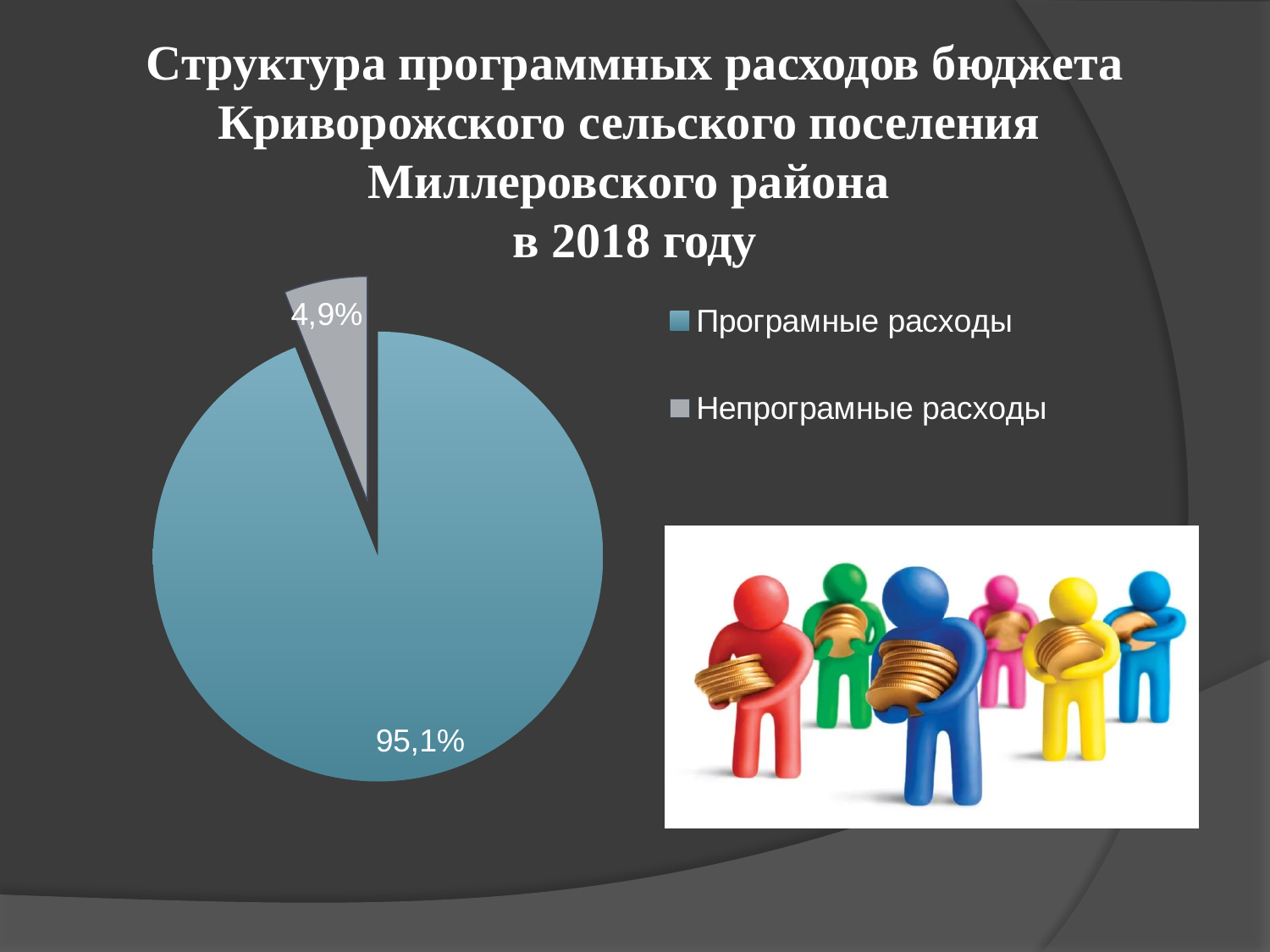
What share of the pie does Програмные расходы take? 95,1% How many slices does the pie chart have? 2 What colour is the slice for Програмные расходы? blue What kind of chart is shown on the slide? pie chart Which category has the smallest slice of the pie? Непрограмные расходы What is the difference between the shares of Програмные расходы and Непрограмные расходы? 90,2% How many entries does the legend list? 2 Which category has the largest slice of the pie? Програмные расходы Which is larger: the share of Програмные расходы or the share of Непрограмные расходы? Програмные расходы What colour is the slice for Непрограмные расходы? grey What share of the pie does Непрограмные расходы take? 4,9%